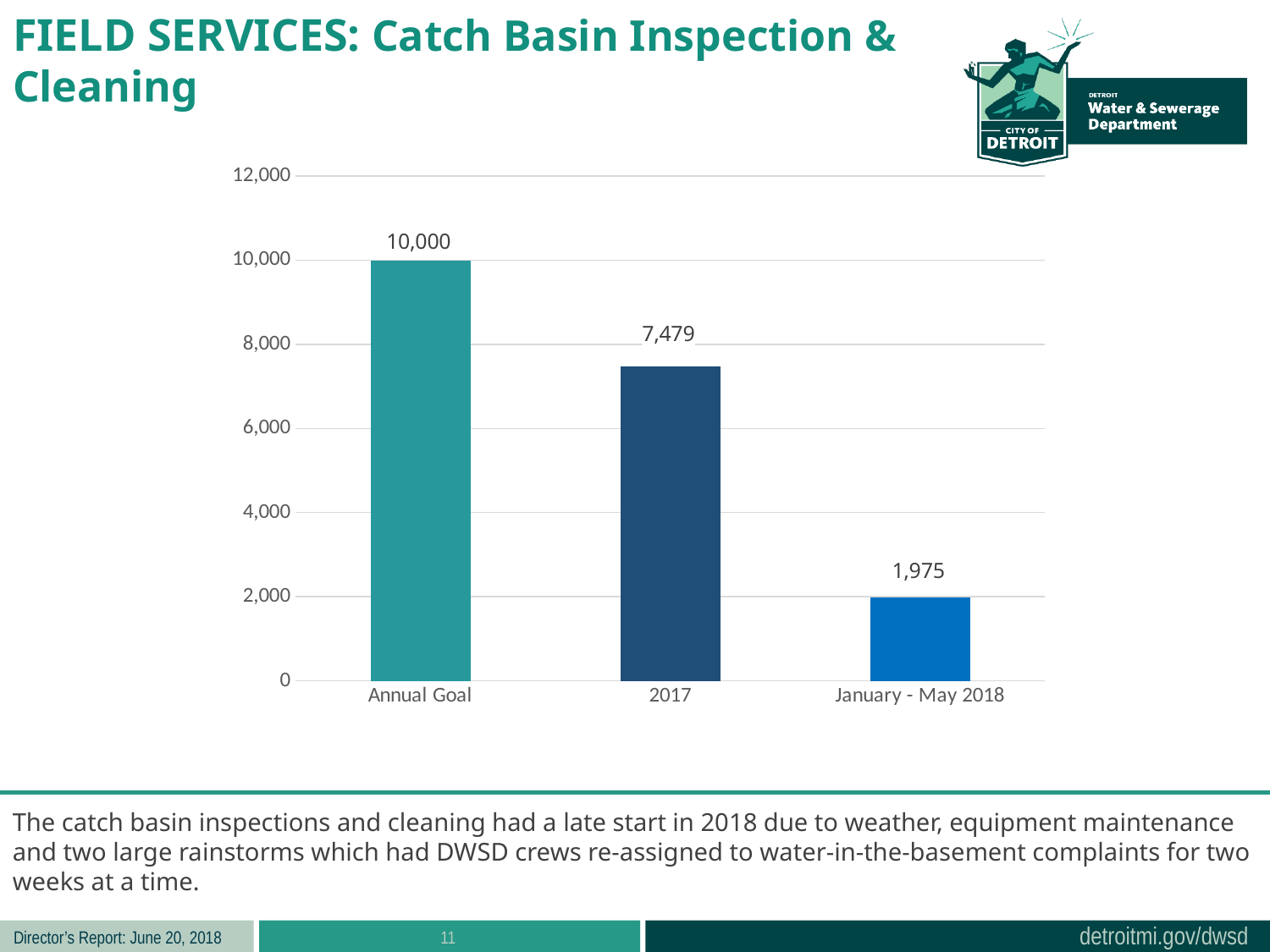
What is the difference between the 2017 value and the January - May 2018 value? 5,504 What kind of chart is shown on the slide? bar chart What is the value for Annual Goal? 10,000 What is the value for January - May 2018? 1,975 What is the value for 2017? 7,479 Which category has the lowest value? January - May 2018 Is the value for 2017 greater or less than 8,000? less Do the values rise or fall from left to right along the x axis? fall Which category has the highest value? Annual Goal Which is larger, the value for 2017 or the value for January - May 2018? 2017 How many categories are shown on the x axis? 3 What is the difference between the Annual Goal and the 2017 value? 2,521